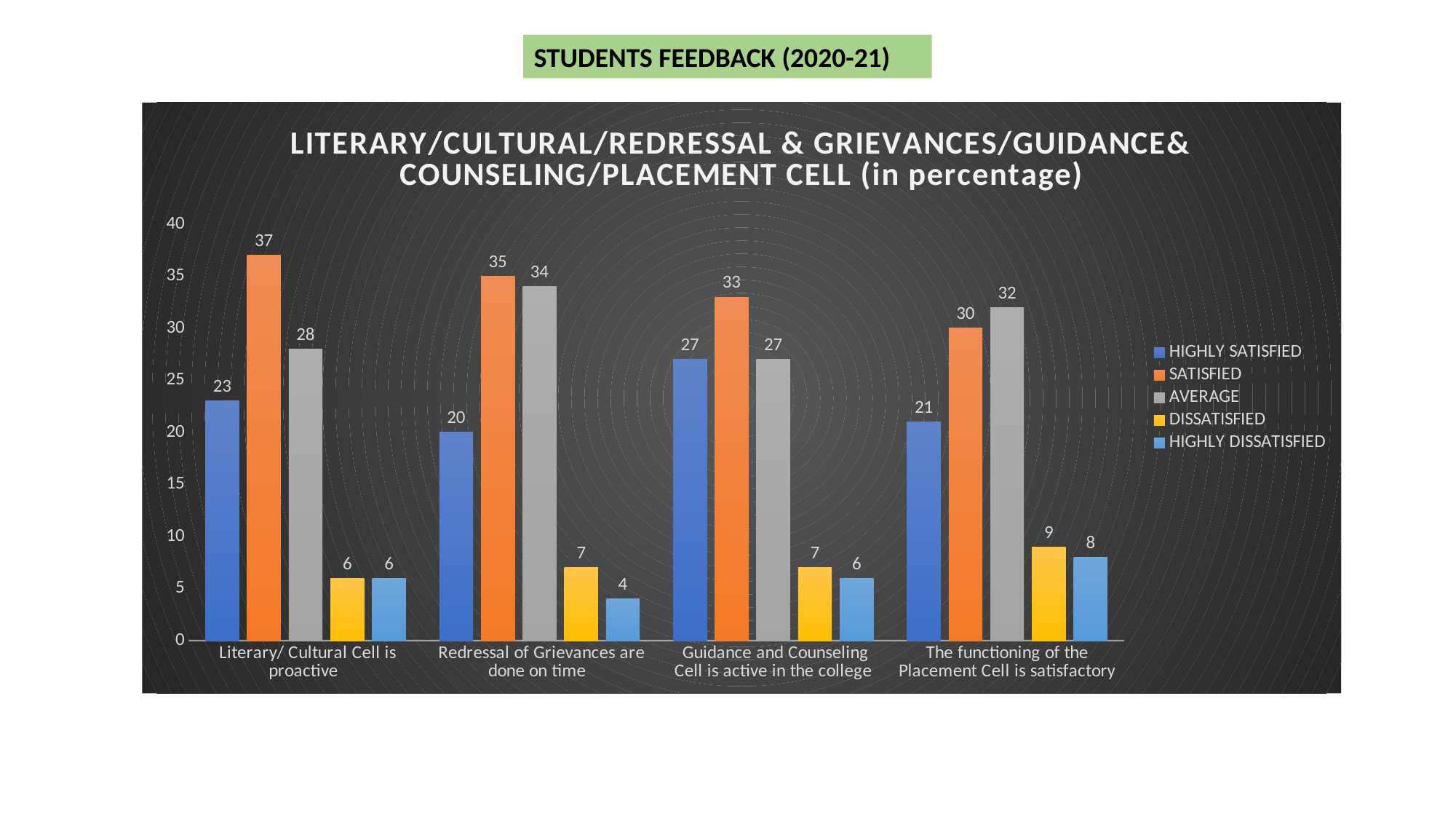
What is the SATISFIED value for 'Literary/ Cultural Cell is proactive'? 37 What kind of chart is shown on the slide? Bar chart Which category has the lowest HIGHLY SATISFIED value? Redressal of Grievances are done on time How many categories are shown on the x axis? 4 What is the AVERAGE value for 'The functioning of the Placement Cell is satisfactory'? 32 What is the difference between the SATISFIED and AVERAGE values for 'Literary/ Cultural Cell is proactive'? 9 Which series is shown in orange in the legend? SATISFIED What is the HIGHLY DISSATISFIED value for 'Redressal of Grievances are done on time'? 4 For 'The functioning of the Placement Cell is satisfactory', which is larger: the SATISFIED value or the AVERAGE value? AVERAGE Which category has the highest SATISFIED value? Literary/ Cultural Cell is proactive What is the HIGHLY SATISFIED value for 'Guidance and Counseling Cell is active in the college'? 27 How many series does the legend list? 5